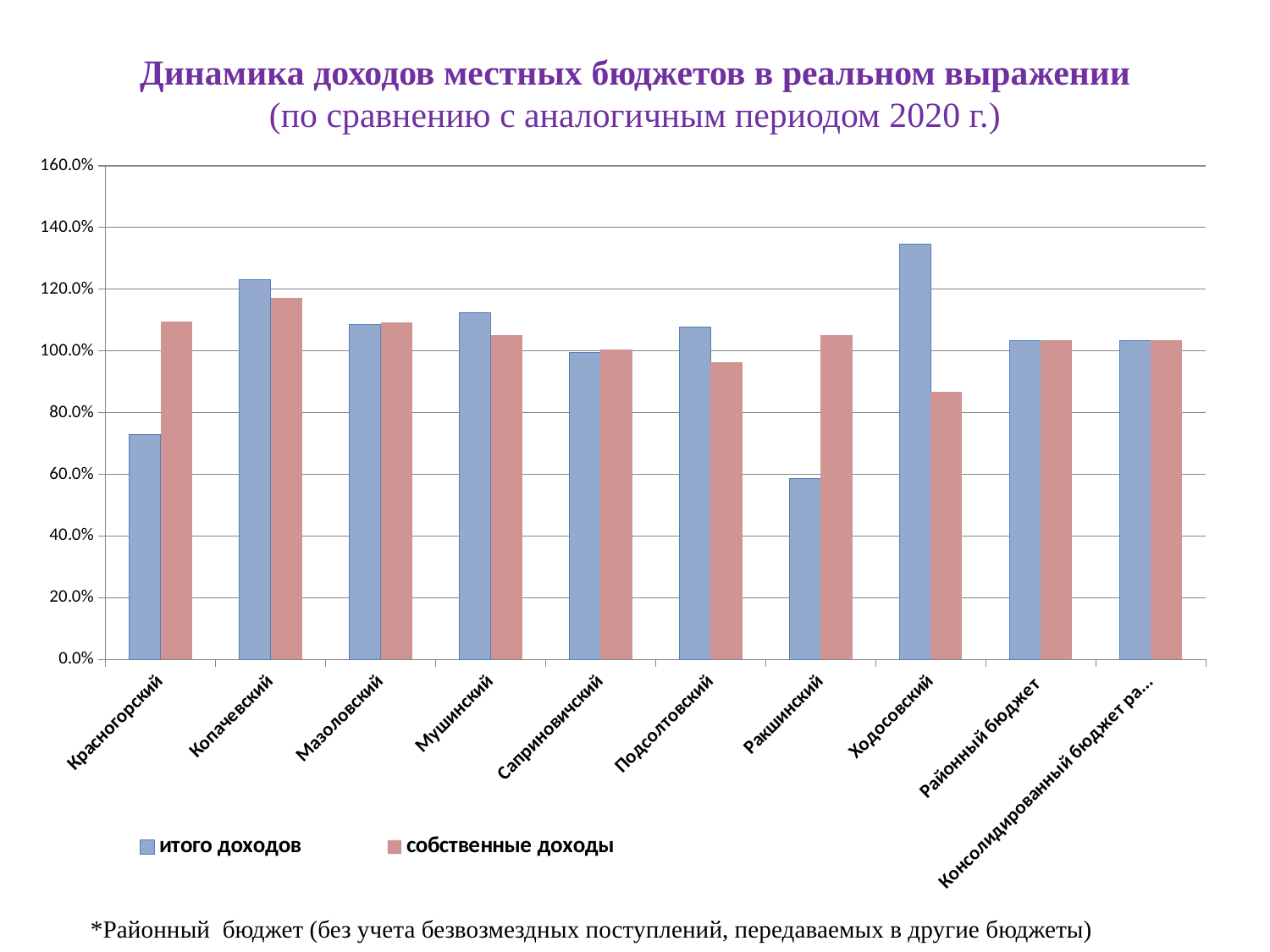
Which category has the lowest value for итого доходов? Ракшинский Which category has the highest value for собственные доходы? Копачевский How many series does the legend list? 2 Which category has the lowest value for собственные доходы? Ходосовский What kind of chart is shown on the slide? bar chart For Ракшинский, which is larger: итого доходов or собственные доходы? собственные доходы Is the value of итого доходов for Ходосовский greater or less than 120.0%? greater Which category has the highest value for итого доходов? Ходосовский How many categories are shown on the x axis? 10 Is the value of итого доходов for Красногорский greater or less than 80.0%? less For Подсолтовский, which is larger: итого доходов or собственные доходы? итого доходов Is the value of собственные доходы for Ходосовский greater or less than 100.0%? less